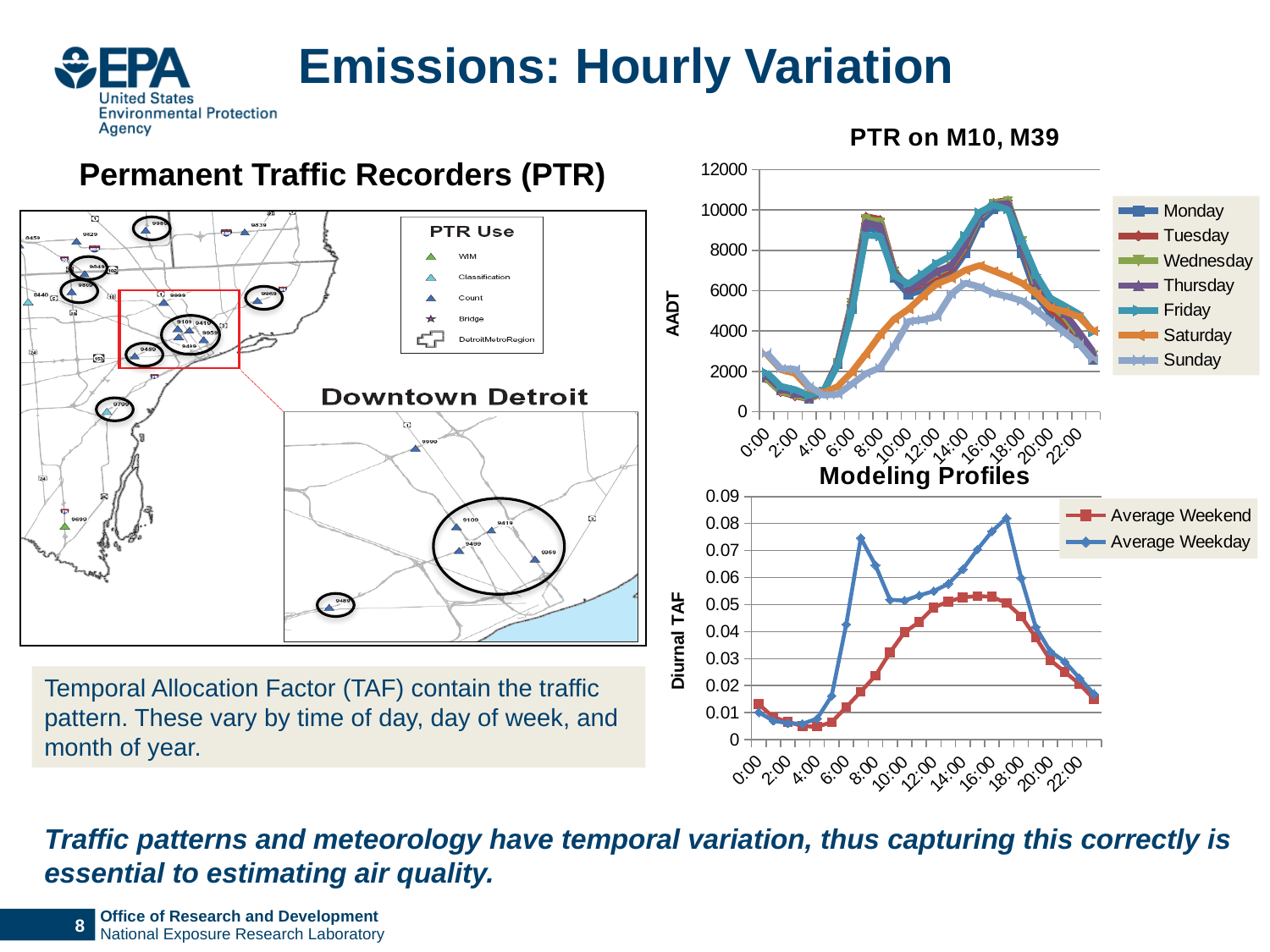
How many series does the legend of the 'PTR on M10, M39' chart list? 7 What kind of chart is the 'Modeling Profiles' chart? line chart In the 'PTR on M10, M39' chart, which is larger at 8:00, Monday or Saturday? Monday In the 'PTR on M10, M39' chart, is the Sunday value at 0:00 greater or less than 2000? greater In the 'Modeling Profiles' chart, which series is larger at 8:00, Average Weekend or Average Weekday? Average Weekday In the 'PTR on M10, M39' chart, is the highest Saturday value greater or less than 8000? less What kind of chart is the 'PTR on M10, M39' chart? line chart In the 'PTR on M10, M39' chart, do the weekday values rise or fall between 4:00 and 8:00? rise How many series does the legend of the 'Modeling Profiles' chart list? 2 What is the y-axis title of the 'PTR on M10, M39' chart? AADT In the 'Modeling Profiles' chart, is the Average Weekday value at 8:00 greater or less than 0.07? less What is the y-axis title of the 'Modeling Profiles' chart? Diurnal TAF